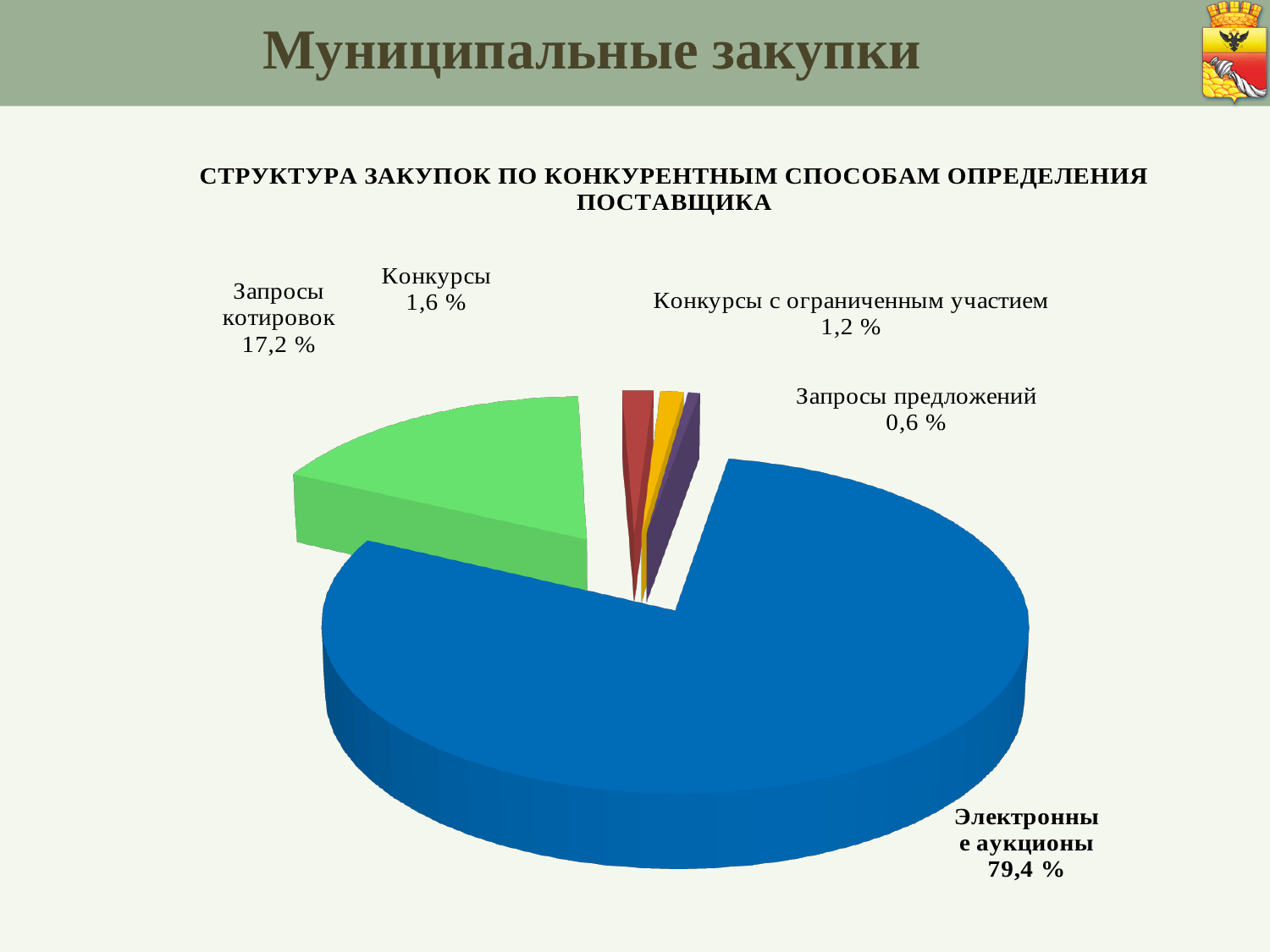
What share of purchases is attributed to Запросы предложений? 0,6 % What kind of chart is shown on the slide? pie chart What is the title of the chart? СТРУКТУРА ЗАКУПОК ПО КОНКУРЕНТНЫМ СПОСОБАМ ОПРЕДЕЛЕНИЯ ПОСТАВЩИКА Which category has the smallest share of the pie? Запросы предложений Which is larger: the share for Конкурсы or the share for Конкурсы с ограниченным участием? Конкурсы What share of purchases is attributed to Конкурсы с ограниченным участием? 1,2 % How many slices does the pie chart have? 5 Which category has the largest share of the pie? Электронные аукционы What share of purchases is attributed to Электронные аукционы? 79,4 % What share of purchases is attributed to Конкурсы? 1,6 % What is the difference in percentage points between Электронные аукционы and Запросы котировок? 62,2 What share of purchases is attributed to Запросы котировок? 17,2 %